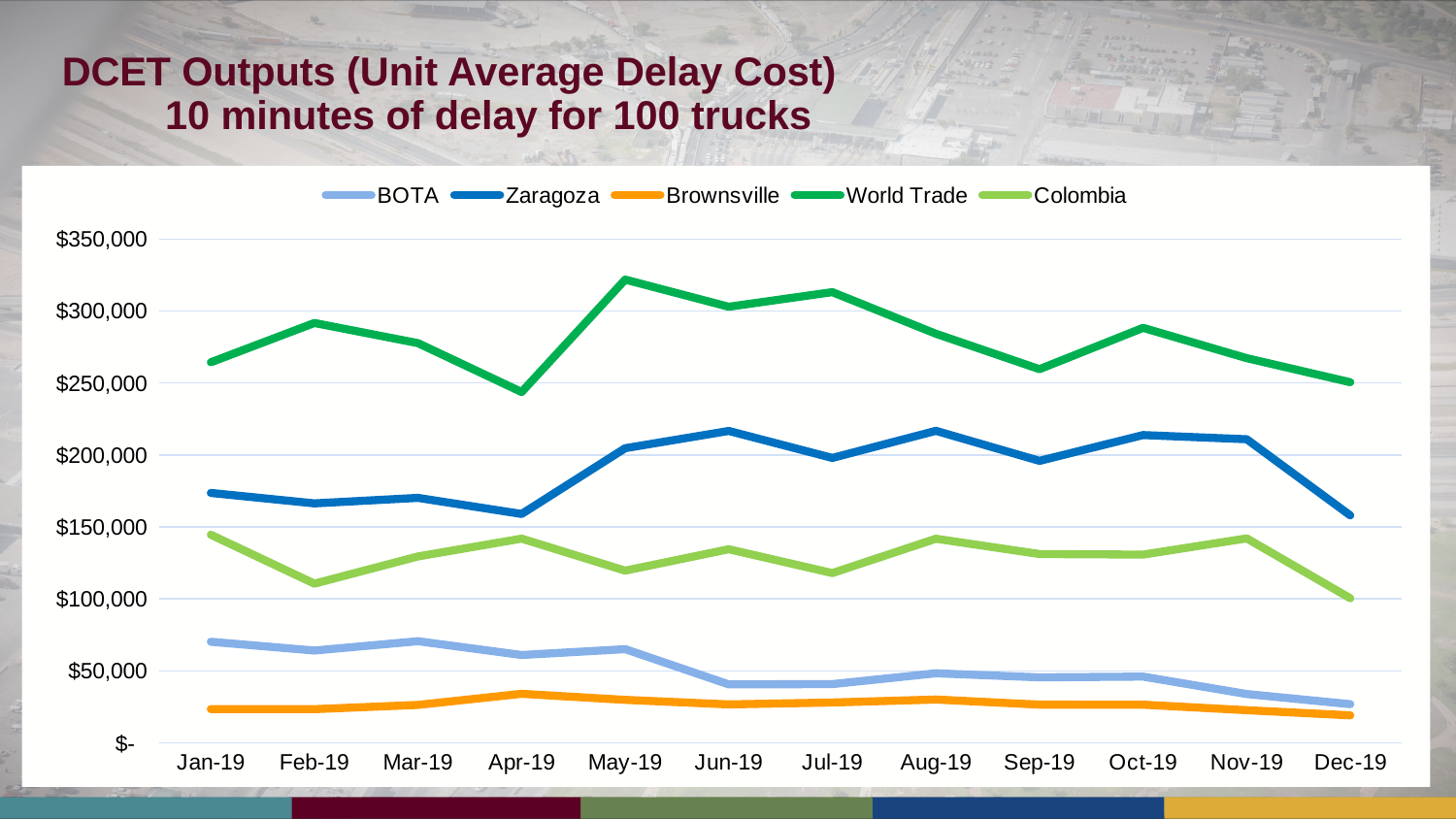
How many series does the legend list? 5 What kind of chart is shown on the slide? Line chart Is the value for Zaragoza in Dec-19 greater or less than $200,000? less Is the value for BOTA in Jan-19 greater or less than $50,000? greater How many months are plotted along the x axis? 12 Which series has the lowest values across the whole chart? Brownsville Is the value for World Trade in May-19 greater or less than $300,000? greater Does the Zaragoza line rise or fall from Nov-19 to Dec-19? Fall In which month does the Colombia line reach its lowest value? Dec-19 In Jun-19, which is larger: the value for Zaragoza or the value for Colombia? Zaragoza In which month does the World Trade line reach its highest value? May-19 Which series has the highest values across the whole chart? World Trade